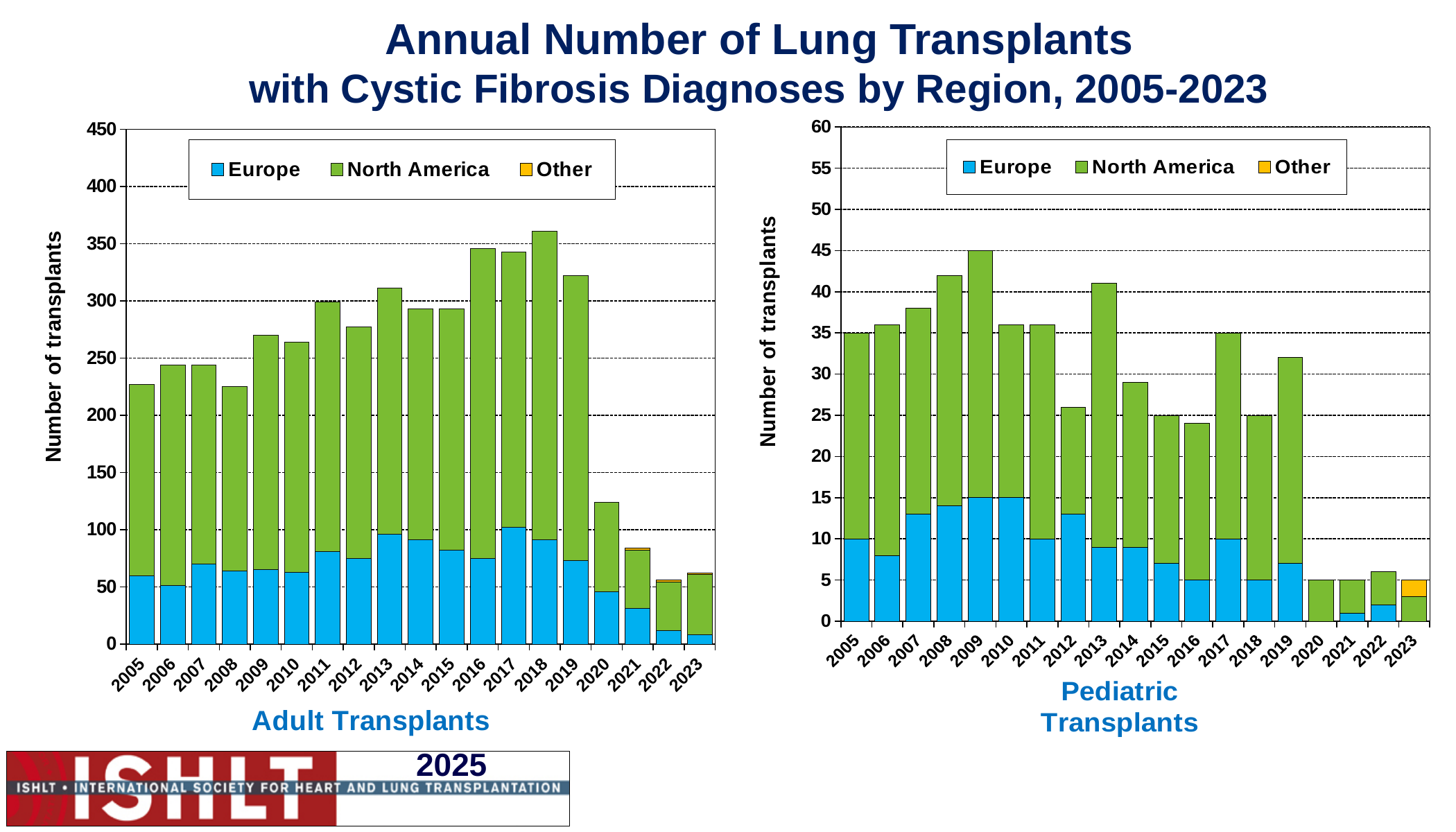
In the Pediatric Transplants chart, which year has the highest total number of transplants? 2009 In the Adult Transplants chart, which year has the highest total number of transplants? 2018 In the Pediatric Transplants chart, what colour represents Europe in the legend? blue In the Adult Transplants chart, which year has the larger total, 2016 or 2020? 2016 In the Adult Transplants chart, do the total values rise or fall from 2019 to 2022? fall In the Adult Transplants chart, is the total for 2020 greater or less than 150? less How many series does the legend of the Pediatric Transplants chart list? 3 In the Adult Transplants chart, which year has the lowest total number of transplants? 2022 In the Pediatric Transplants chart, is the total for 2017 greater or less than 30? greater How many years are shown on the x axis of the Adult Transplants chart? 19 What kind of chart is the Adult Transplants chart? stacked bar chart In the Adult Transplants chart, is the total for 2018 greater or less than 350? greater